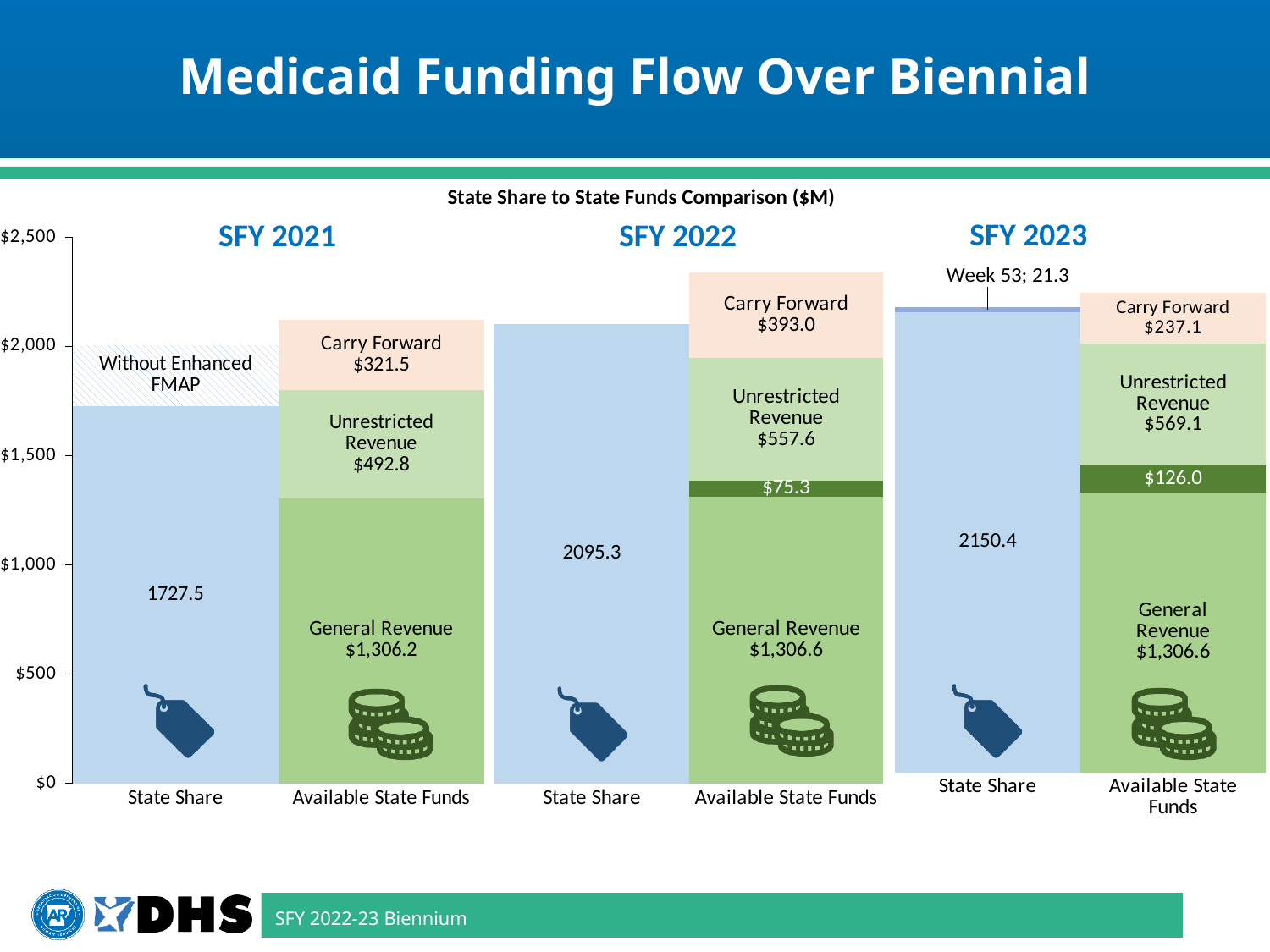
Which fiscal year has the highest State Share value? SFY 2023 What is the General Revenue amount in the SFY 2022 Available State Funds bar? $1,306.6 What type of chart is shown on the slide? Stacked bar chart What is the Carry Forward amount for SFY 2023? $237.1 Is the Carry Forward amount larger in SFY 2021 or SFY 2023? SFY 2021 What is the Unrestricted Revenue amount for SFY 2021? $492.8 What is the total of the SFY 2021 Available State Funds bar (Carry Forward $321.5, Unrestricted Revenue $492.8, General Revenue $1,306.2)? $2,120.5 What is the State Share value for SFY 2021? 1727.5 What is the difference between the SFY 2022 State Share (2095.3) and the SFY 2021 State Share (1727.5)? 367.8 Which fiscal year has the largest Carry Forward amount? SFY 2022 Is the SFY 2021 State Share value greater or less than $2,000? less What is the State Share value for SFY 2023? 2150.4